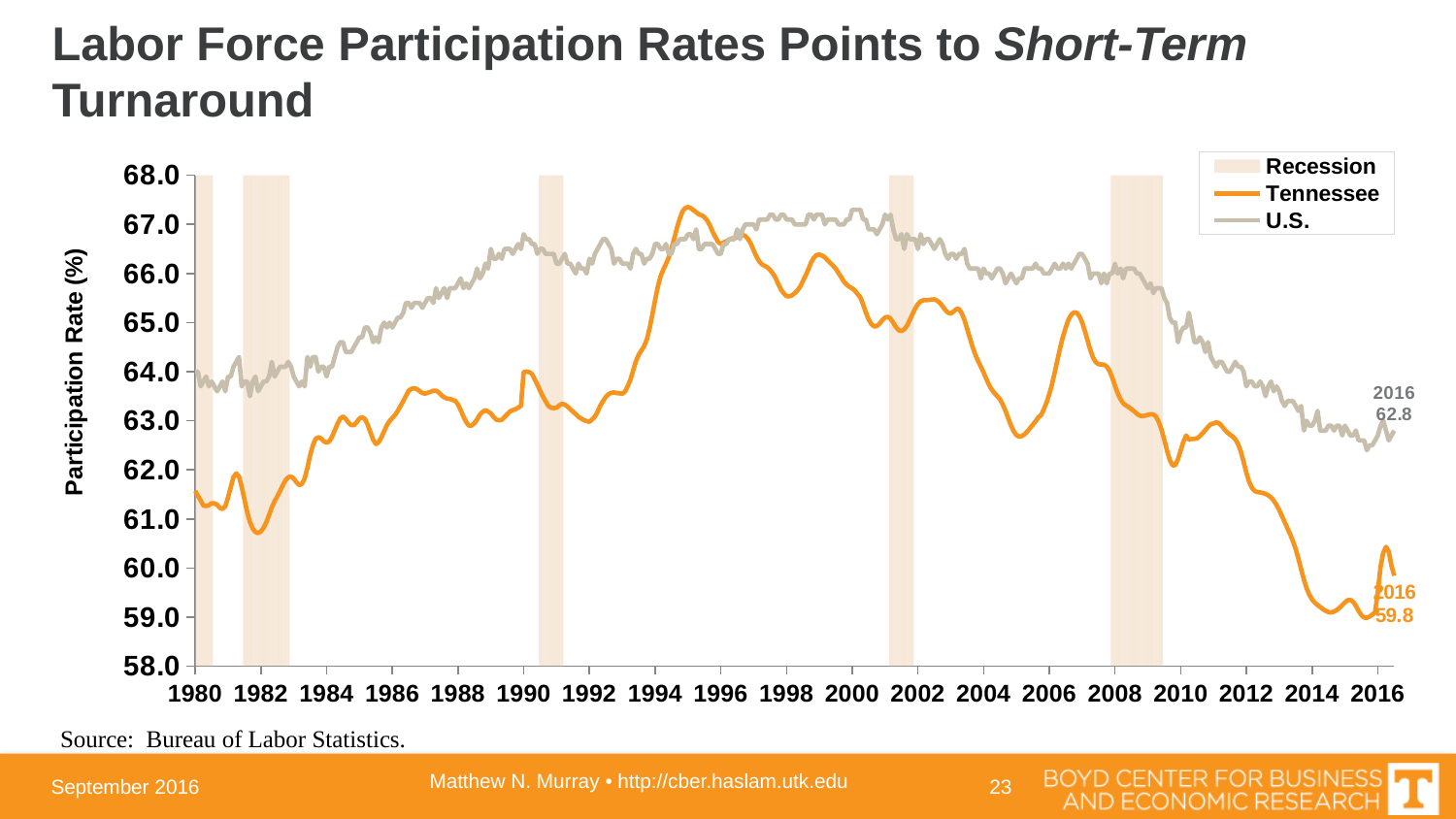
Is the value for Tennessee in 2014 greater or less than 60.0? less How many entries does the legend list? 3 What is the labeled 2016 value for the Tennessee series? 59.8 What is the labeled 2016 value for the U.S. series? 62.8 Does the U.S. participation rate rise or fall between 2008 and 2016? fall What is the title of the vertical axis? Participation Rate (%) What is the difference between the labeled 2016 U.S. value and the labeled 2016 Tennessee value? 3.0 Is the value for Tennessee in 1980 greater or less than 62.0? less Does the Tennessee participation rate rise or fall between 1980 and 1995? rise What kind of chart is shown on the slide? Line chart Is the value for the U.S. in 1980 greater or less than 63.0? greater In 2016, which series has the higher labeled participation rate, Tennessee or U.S.? U.S.